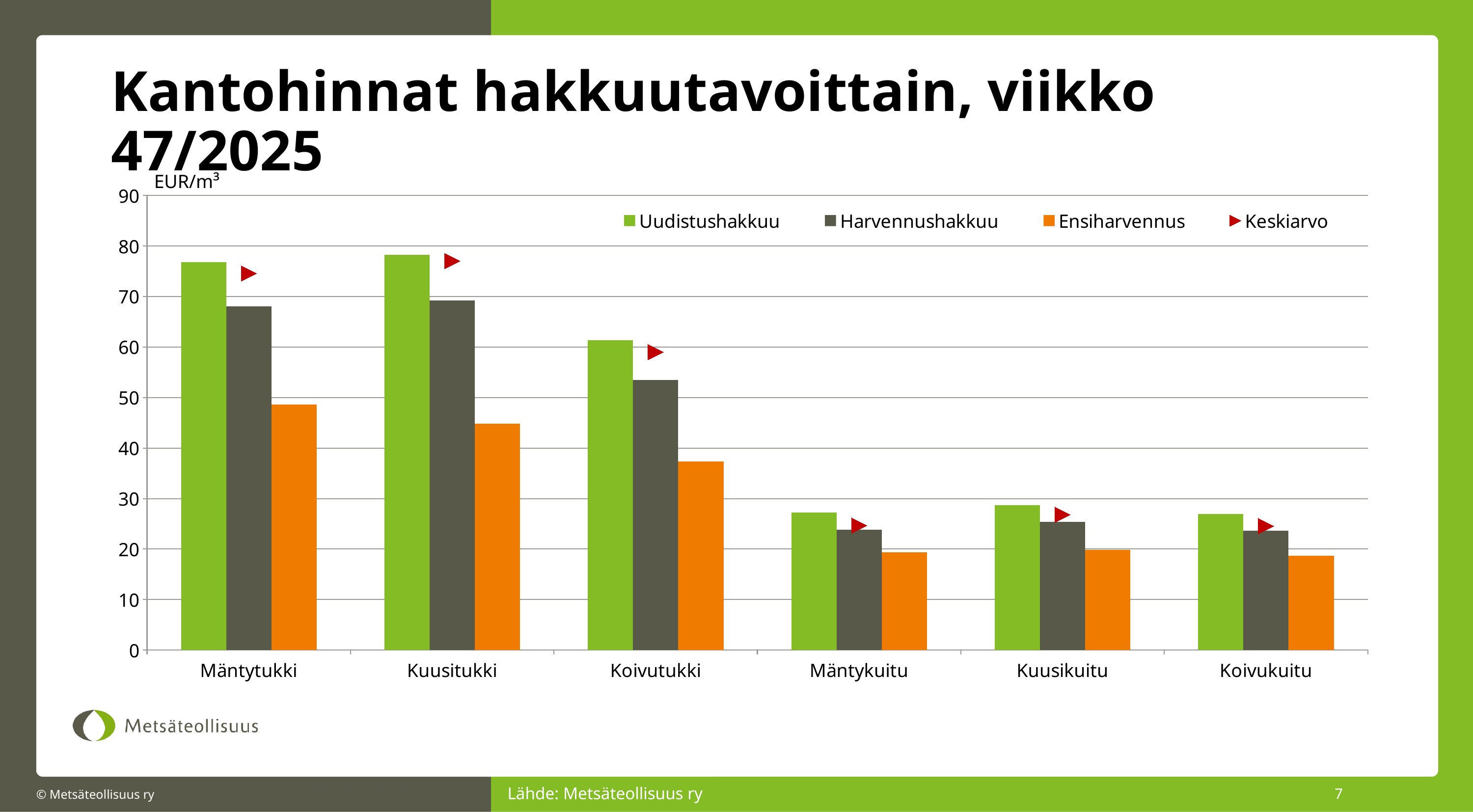
How many series does the legend list? 4 Is the Ensiharvennus value for Kuusitukki greater or less than 40? greater Which is larger, the Harvennushakkuu value for Mäntytukki or for Koivutukki? Mäntytukki How many categories are shown on the x axis? 6 Is the Ensiharvennus value for Koivutukki greater or less than 40? less Which category has the highest Ensiharvennus value? Mäntytukki What unit is shown on the y axis? EUR/m³ Is the Harvennushakkuu value for Mäntykuitu greater or less than 20? greater What kind of chart is shown on the slide? bar chart Which is larger, the Uudistushakkuu value for Kuusikuitu or for Koivutukki? Koivutukki Which colour represents the Ensiharvennus series? orange